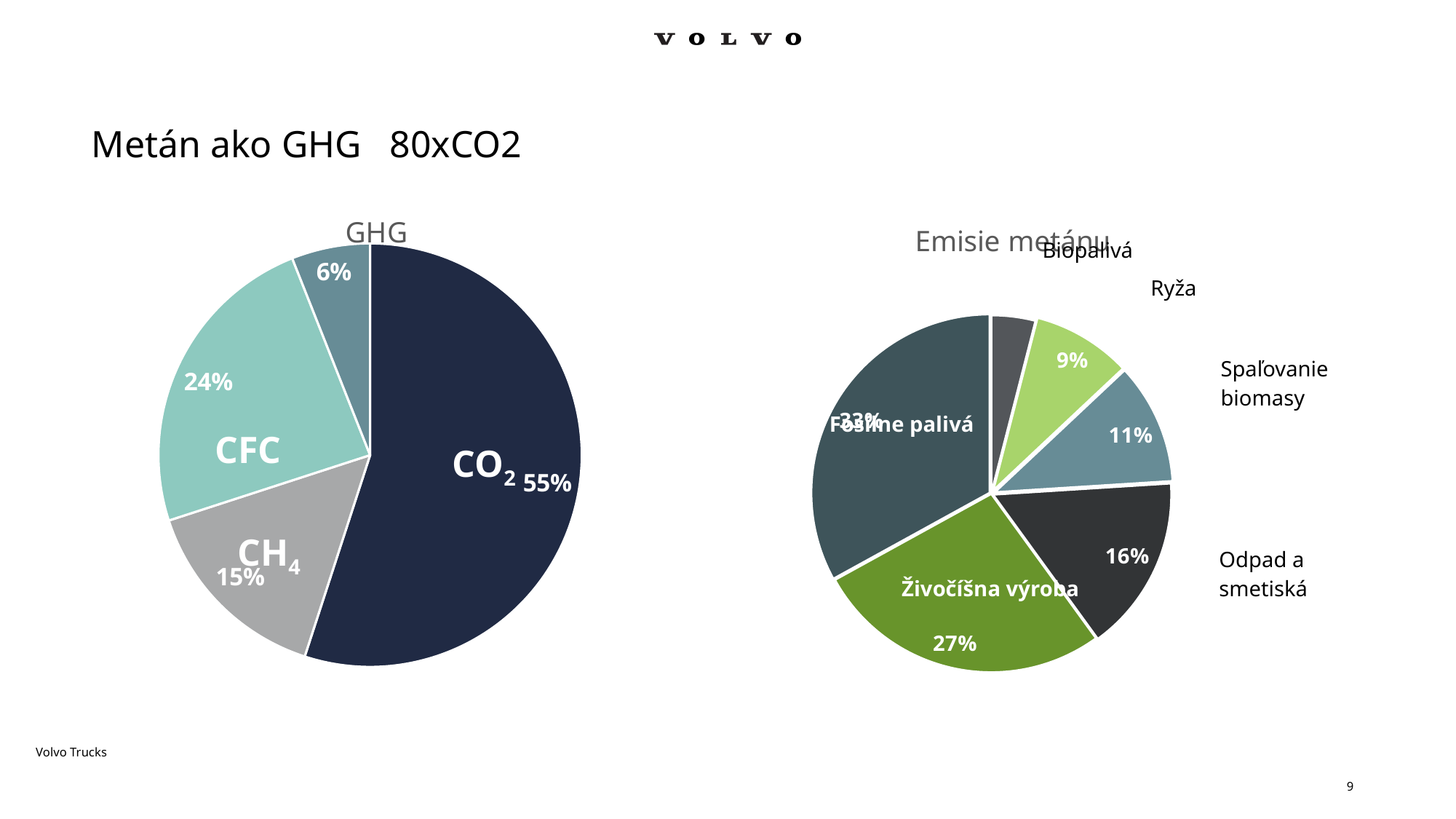
In the GHG pie chart, what share does CFC have? 24% In the Emisie metánu pie chart, what share does Ryža have? 9% In the GHG pie chart, what share does CO2 have? 55% In the GHG pie chart, which category has the largest share? CO2 In the GHG pie chart, what share does CH4 have? 15% In the Emisie metánu pie chart, what share does Odpad a smetiská have? 16% In the GHG pie chart, how many slices does the pie have? 4 In the Emisie metánu pie chart, which is larger, Spaľovanie biomasy or Ryža? Spaľovanie biomasy In the Emisie metánu pie chart, what is the difference between Živočíšna výroba and Odpad a smetiská? 11% What type of chart is used for the Emisie metánu chart? Pie chart In the GHG pie chart, what is the difference between the CFC share and the CH4 share? 9% In the Emisie metánu pie chart, what share does Živočíšna výroba have? 27%